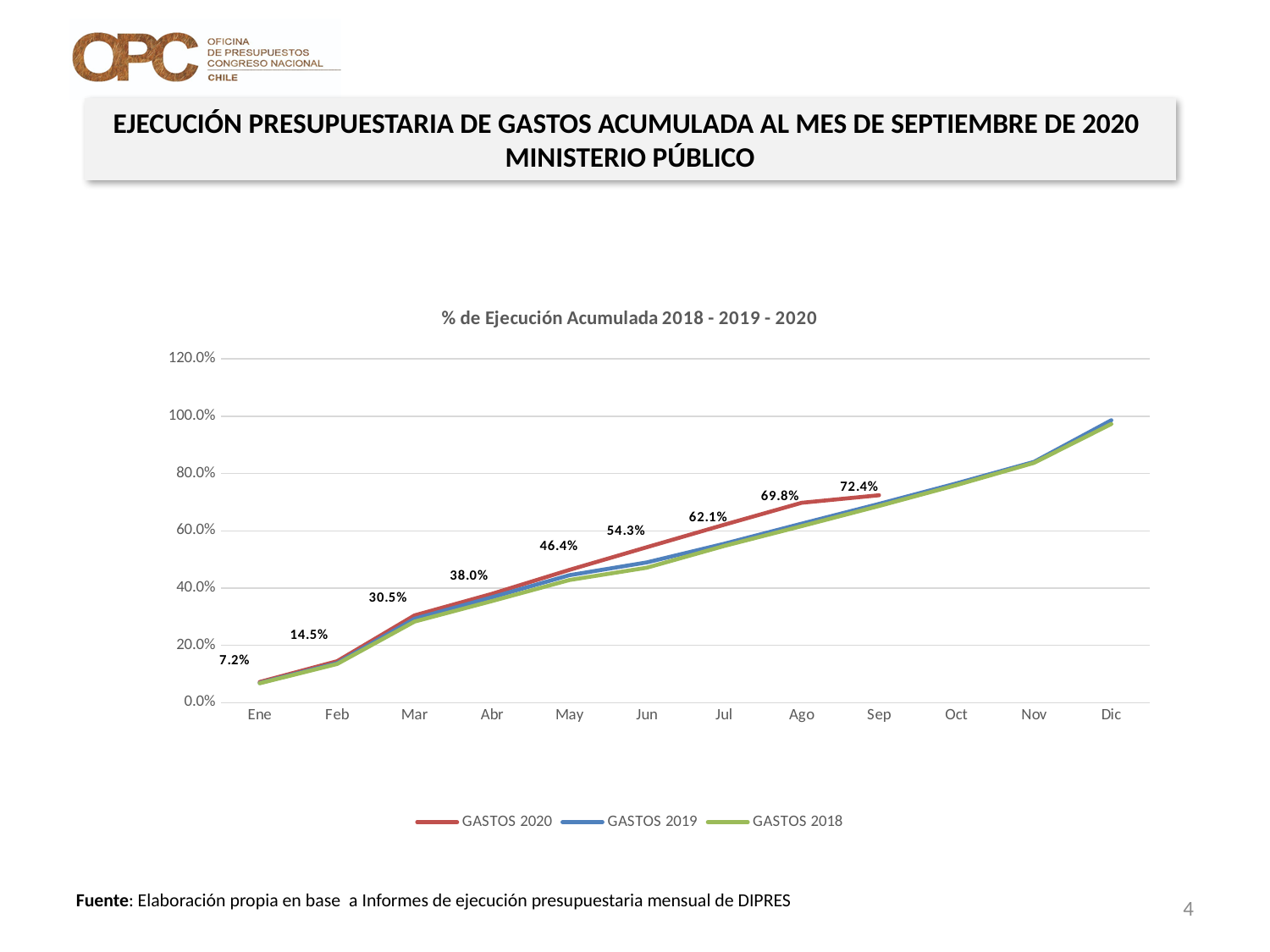
What is the value for GASTOS 2020 in May? 46.4% What is the value for GASTOS 2020 in Ene? 7.2% What is the value for GASTOS 2020 in Sep? 72.4% How many months are shown on the x axis? 12 How many series does the legend list? 3 What type of chart is shown on the slide? line chart What is the title of the chart? % de Ejecución Acumulada 2018 - 2019 - 2020 Does the GASTOS 2020 line rise or fall from Ene to Sep? rise Is the value for GASTOS 2019 in Dic greater or less than 80.0%? greater What is the difference between the GASTOS 2020 values for Mar and Feb? 16.0% In Sep, which is larger: GASTOS 2020 or GASTOS 2018? GASTOS 2020 What is the difference between the GASTOS 2020 values for Ago and Jul? 7.7%